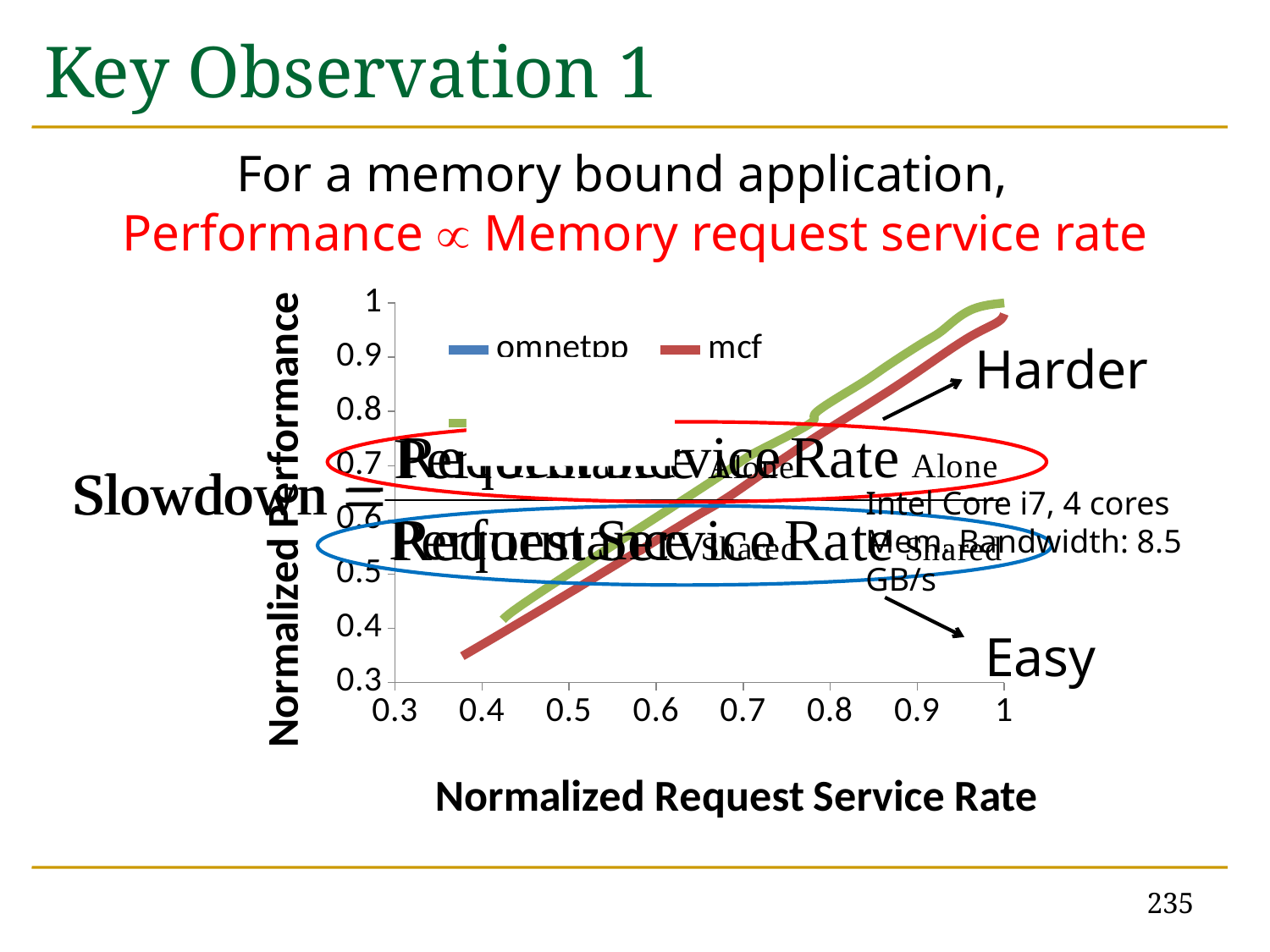
What is the highest value shown on the y axis of the chart? 1 What is the label of the x axis of the chart? Normalized Request Service Rate What kind of chart is shown on the slide? line chart Is the lowest plotted normalized performance value for mcf greater or less than 0.4? less Do the plotted values for mcf rise or fall as the normalized request service rate increases? rise Is the normalized performance of mcf at a normalized request service rate of 1 greater or less than 0.9? greater